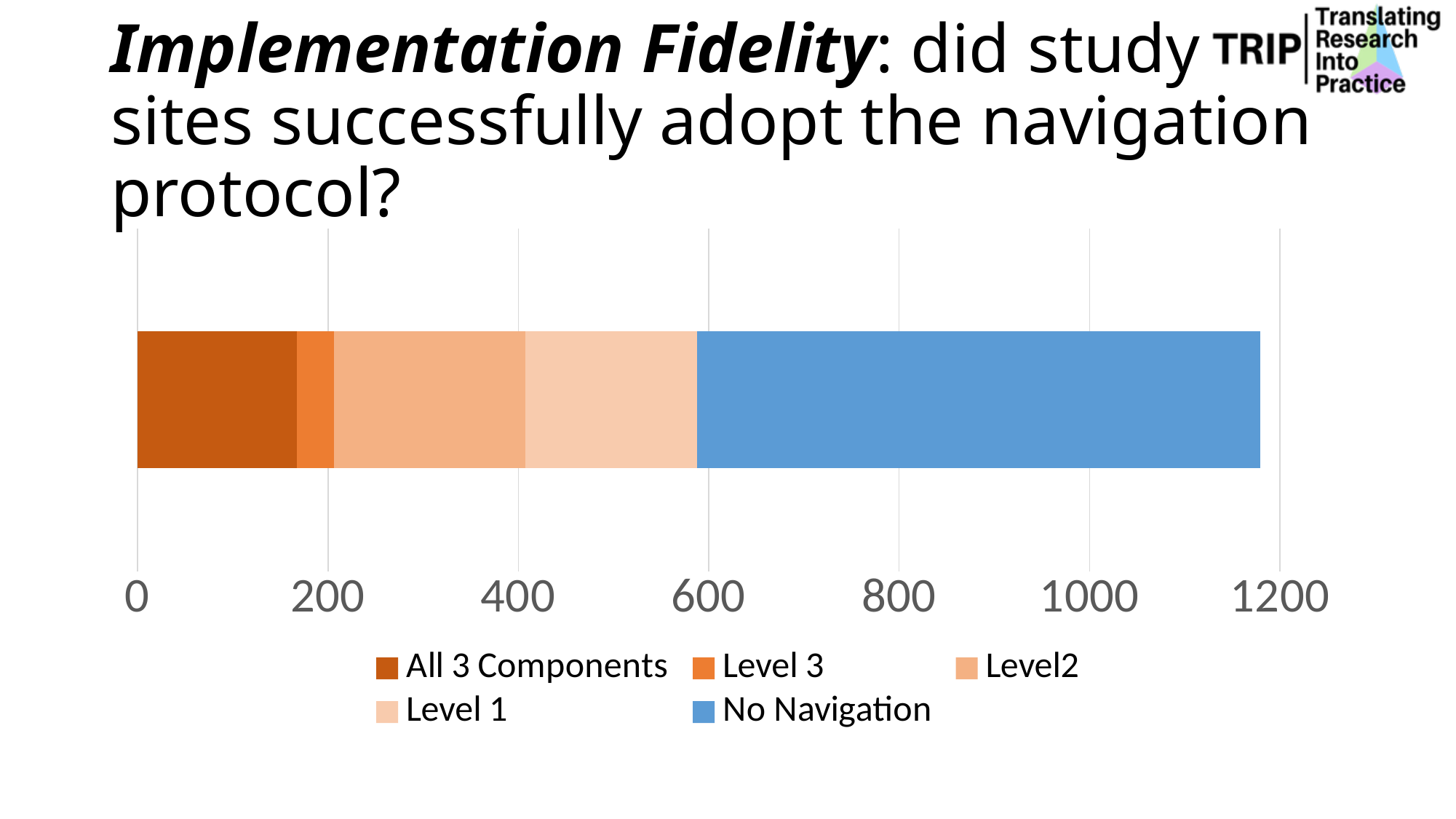
How many series does the legend list? 5 Is the total length of the stacked bar greater or less than 1000? greater Which segment is larger, No Navigation or Level2? No Navigation Is the width of the All 3 Components segment greater or less than 200? less Is the width of the No Navigation segment greater or less than 400? greater How many bars are plotted in the chart? 1 Which series has the largest segment in the bar? No Navigation What is the highest value shown on the horizontal axis? 1200 What kind of chart is shown on the slide? Stacked bar chart What colour is used for the No Navigation series? Blue Which segment is larger, Level2 or Level 3? Level2 Which series has the smallest segment in the bar? Level 3